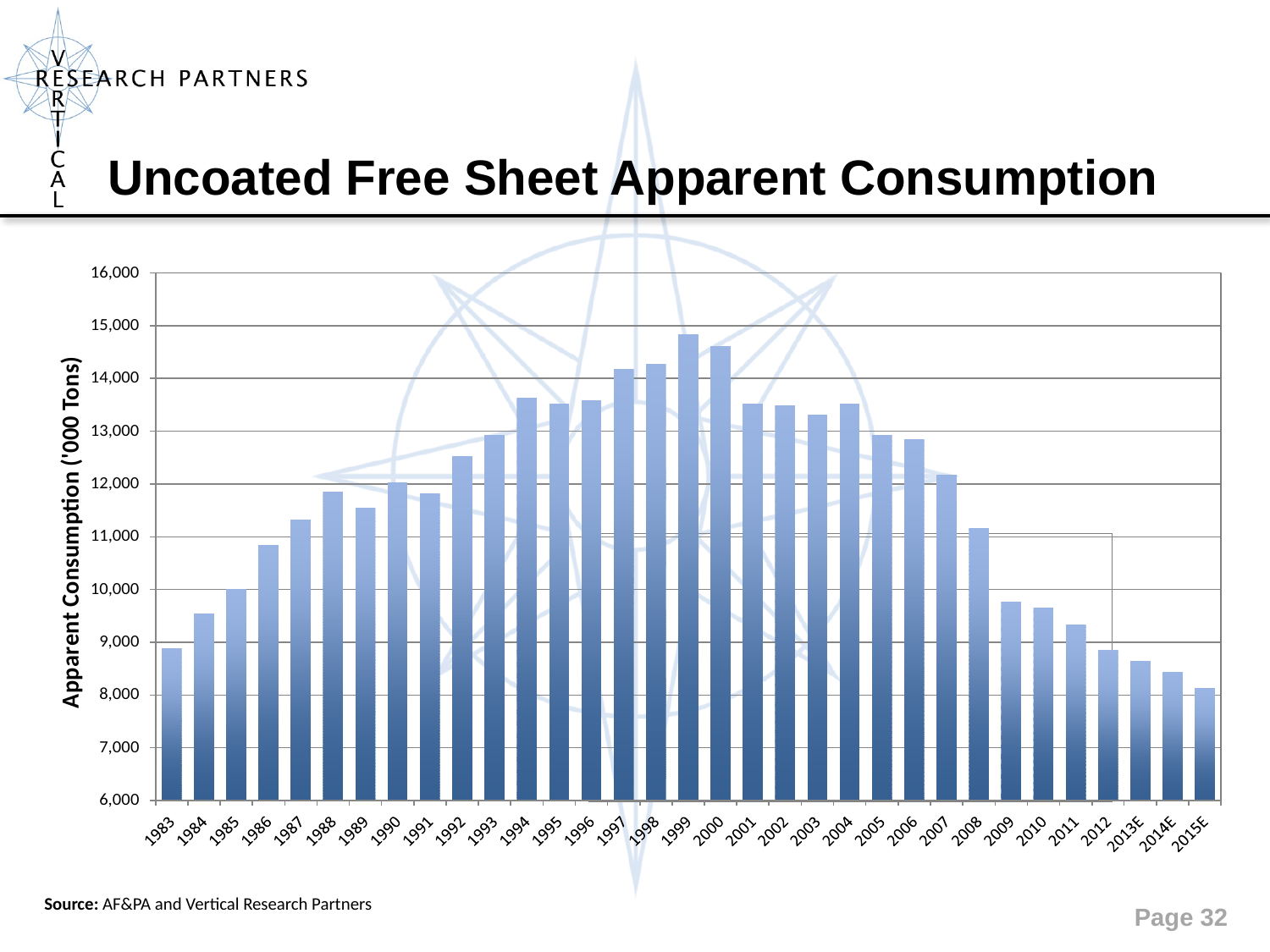
Is the value for 2012 greater or less than 9,000? less Do the values generally rise or fall from 1999 to 2015E? fall Which year has the highest apparent consumption? 1999 What is the label on the vertical axis? Apparent Consumption ('000 Tons) Is the value for 1999 greater or less than 14,000? greater How many years (bars) are plotted on the chart? 33 Is the value for 1986 greater or less than 11,000? less What kind of chart is shown on the slide? bar chart Which year has the larger value, 1983 or 2015E? 1983 Which year has the larger value, 1999 or 2000? 1999 Which year has the lowest apparent consumption? 2015E